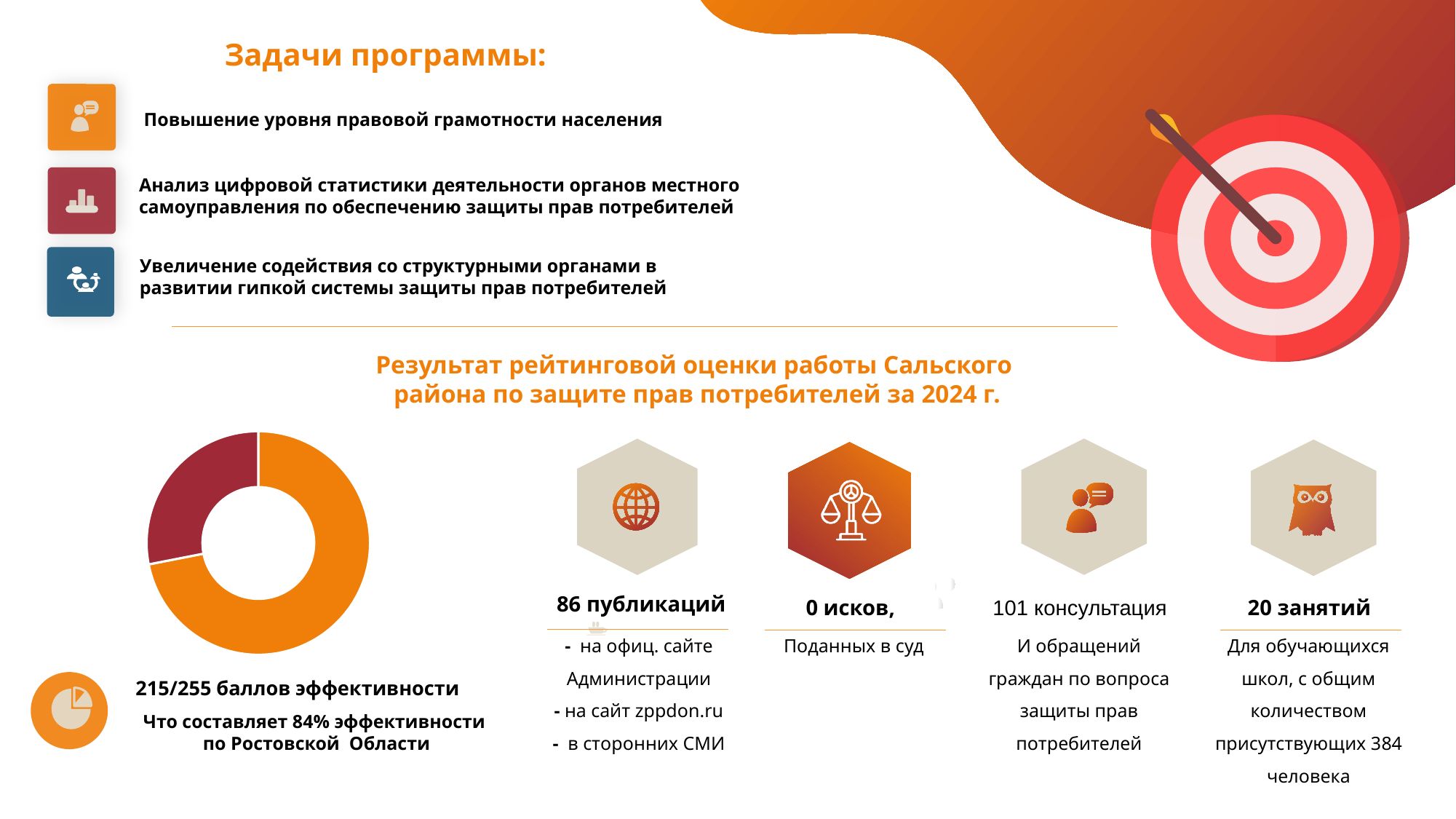
Is the orange slice of the donut chart greater or less than half of the whole? greater What kind of chart is shown on the lower left of the slide? Donut (pie) chart Does the donut chart have a legend? No What percentage of effectiveness does the text next to the donut chart state? 84% What score does the donut chart illustrate, according to the text beside it? 215/255 баллов эффективности Is the dark red slice of the donut chart greater or less than half of the whole? less How many slices does the donut chart have? 2 What two colours are used for the slices of the donut chart? Orange and dark red Which slice of the donut chart is larger, the orange one or the dark red one? The orange one